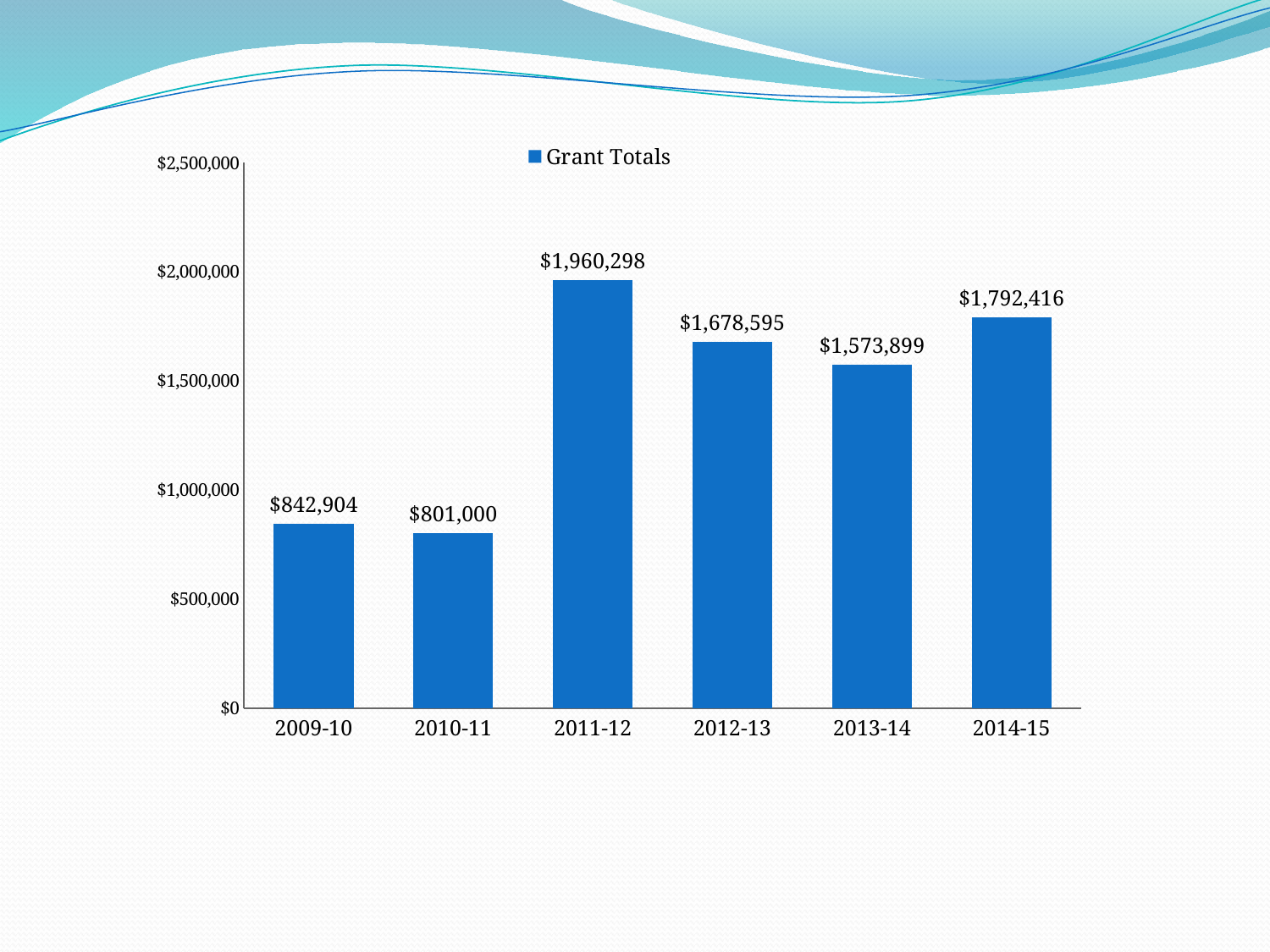
Which year has the lowest Grant Totals value? 2010-11 What is the Grant Totals value for 2011-12? $1,960,298 What kind of chart is shown on the slide? Bar chart What is the Grant Totals value for 2013-14? $1,573,899 What is the name of the series shown in the chart legend? Grant Totals Which year has a larger Grant Totals value, 2012-13 or 2014-15? 2014-15 Is the Grant Totals value for 2012-13 greater or less than $1,500,000? greater What is the Grant Totals value for 2010-11? $801,000 How many years are shown on the x axis of the chart? 6 Which year has the highest Grant Totals value? 2011-12 What is the difference between the Grant Totals for 2014-15 and 2013-14? $218,517 What is the difference between the Grant Totals for 2011-12 and 2009-10? $1,117,394